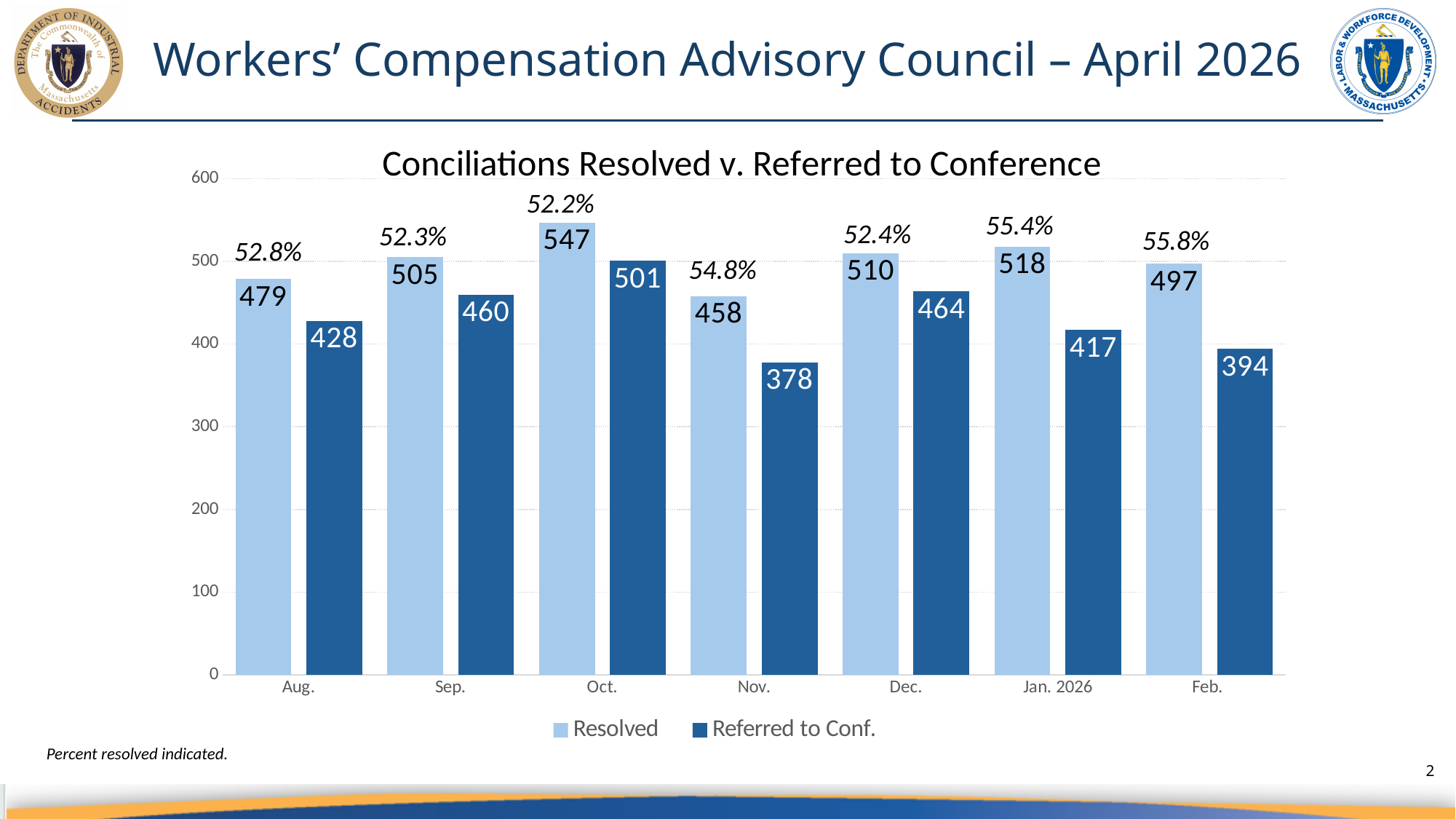
What is the difference between the Resolved and Referred to Conf. values for Jan. 2026? 101 What kind of chart is shown? Bar chart How many series does the legend list? 2 Which is larger, the Referred to Conf. value for Dec. or for Sep.? Dec. Which month has the highest Resolved value? Oct. What is the total of Resolved and Referred to Conf. for Aug.? 907 Which month has the lowest Referred to Conf. value? Nov. What percent resolved is indicated for Feb.? 55.8% What is the title of the chart? Conciliations Resolved v. Referred to Conference What is the Referred to Conf. value for Nov.? 378 How many months are shown on the x axis? 7 What is the Resolved value for Oct.? 547